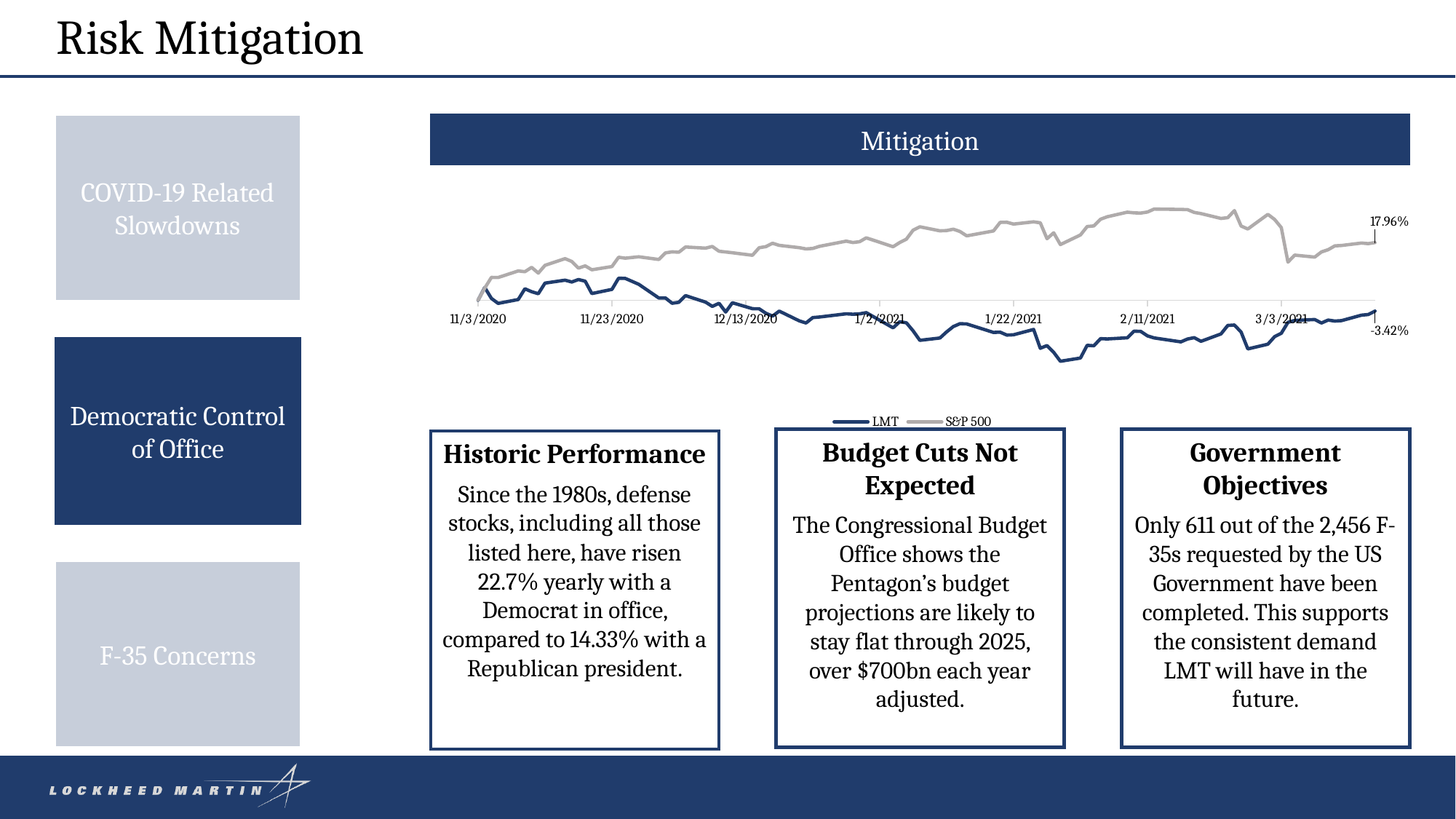
Which series ends at a higher value, LMT or S&P 500? S&P 500 Does the LMT line generally rise or fall from 11/3/2020 to the end of the chart? fall What is the final value labelled for the S&P 500 series? 17.96% What is the first date label on the chart's x axis? 11/3/2020 How many date labels are shown on the x axis of the chart? 7 What colour is the LMT line in the chart? dark blue How many series does the chart's legend list? 2 Does the S&P 500 line generally rise or fall from 11/3/2020 to the end of the chart? rise What type of chart is shown under the Mitigation banner? line chart What is the difference between the final labelled values of the S&P 500 and LMT series? 21.38 percentage points What are the two entries in the chart's legend? LMT and S&P 500 What is the final value labelled for the LMT series? -3.42%